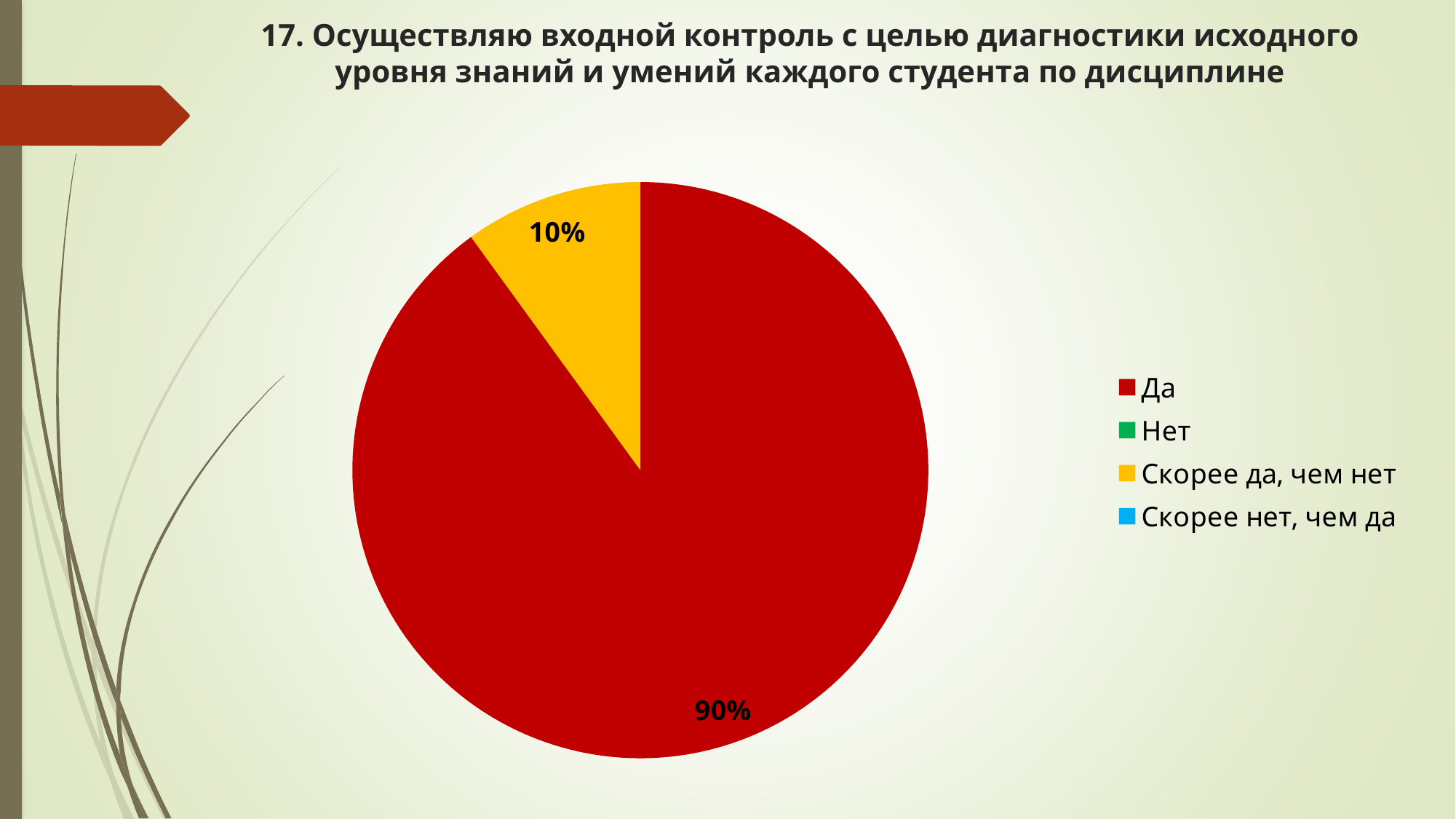
What colour is the "Да" slice? red What share of the pie does the "Да" slice represent? 90% Which is larger, the "Да" slice or the "Скорее да, чем нет" slice? Да What share of the pie does the "Скорее да, чем нет" slice represent? 10% What colour is the "Скорее да, чем нет" slice? yellow Which category has the largest slice of the pie? Да Is the share for "Да" greater or less than 50%? greater What kind of chart is shown on the slide? pie chart What is the difference in percentage points between the "Да" slice and the "Скорее да, чем нет" slice? 80 percentage points How many slices are visible in the pie? 2 How many entries does the legend list? 4